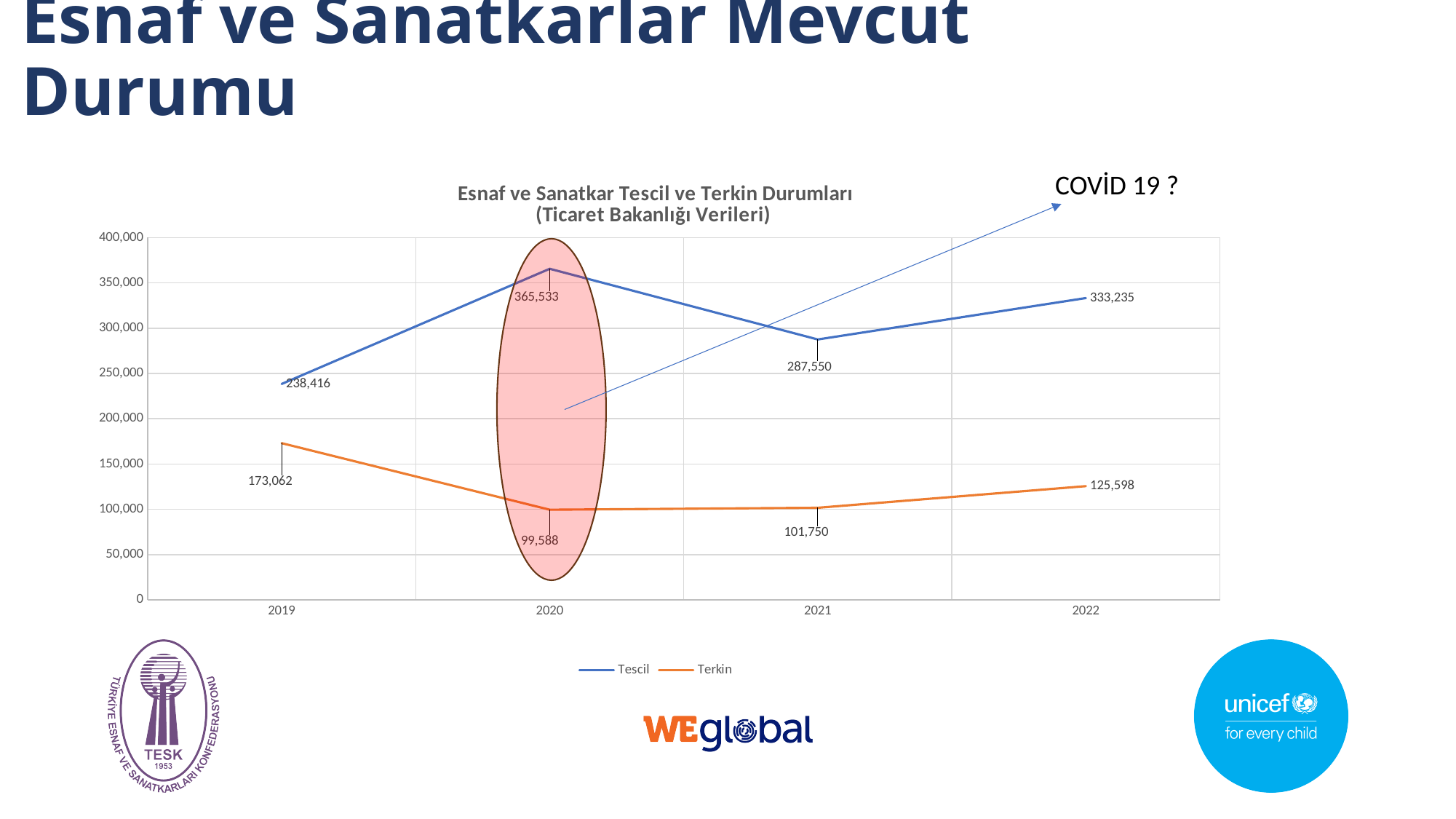
In which year is the Terkin value lowest? 2020 What is the Tescil value for 2020? 365,533 What is the Tescil value for 2022? 333,235 What is the Terkin value for 2021? 101,750 What kind of chart is shown on the slide? line chart In which year is the Tescil value highest? 2020 Which is larger: the Tescil value in 2021 or the Tescil value in 2022? 2022 Does the Terkin line rise or fall from 2019 to 2020? fall What is the difference between the Tescil and Terkin values in 2020? 265,945 How many years are shown on the x axis? 4 How many series does the legend list? 2 What is the Terkin value for 2019? 173,062